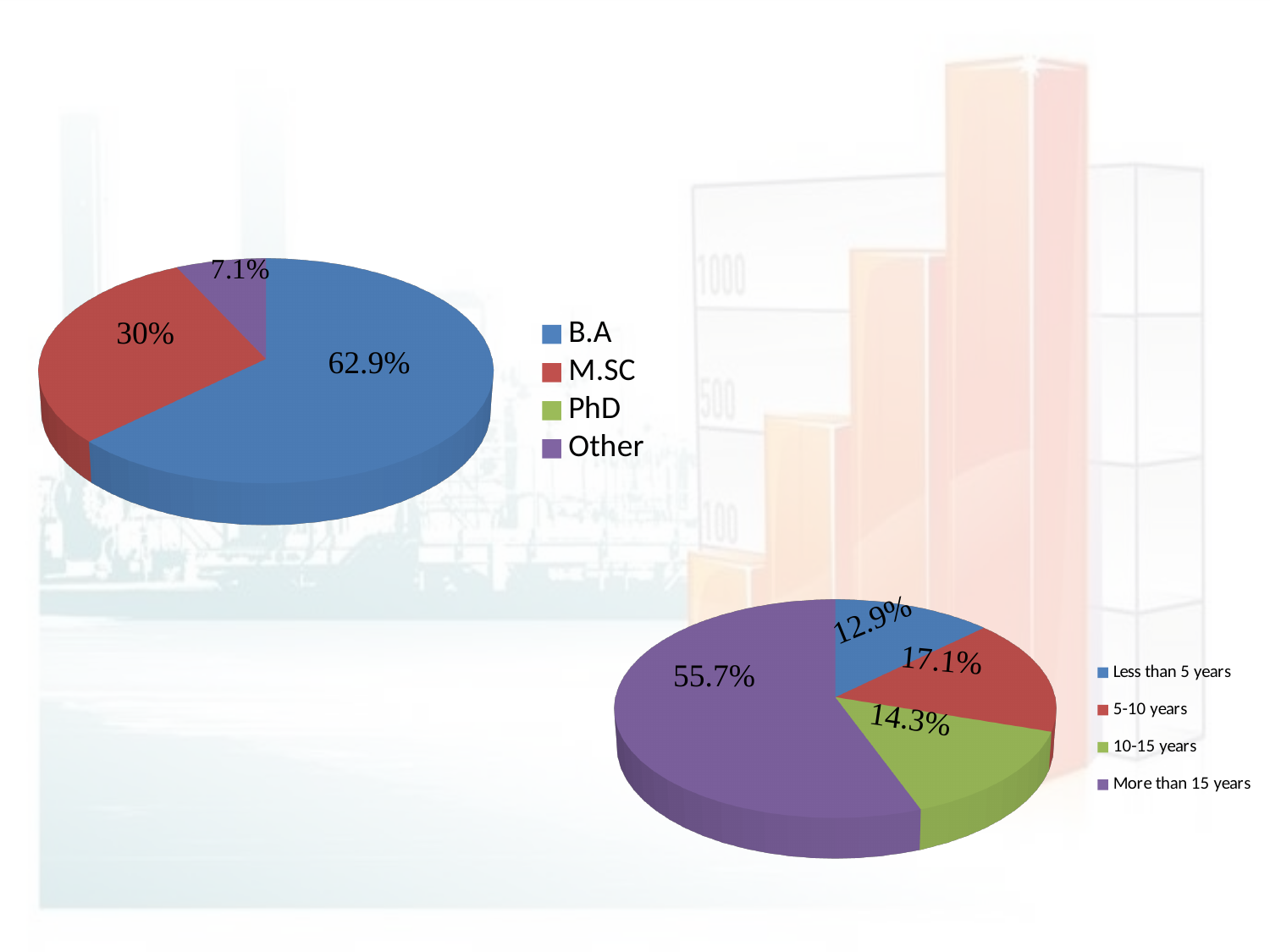
What type of chart is the top-left chart? Pie chart How many categories does the bottom-right pie chart's legend list? 4 In the bottom-right pie chart, which category has the smallest slice? Less than 5 years In the top-left pie chart, what is the difference between the B.A and M.SC percentages? 32.9% In the top-left pie chart, which category has the largest slice? B.A In the top-left pie chart, what percentage is shown for M.SC? 30% In the bottom-right pie chart, which is larger: 5-10 years or 10-15 years? 5-10 years How many entries does the legend of the top-left pie chart list? 4 In the top-left pie chart, what percentage is shown for B.A? 62.9% In the bottom-right pie chart, what percentage is shown for More than 15 years? 55.7% In the bottom-right pie chart, what percentage is shown for 10-15 years? 14.3% In the bottom-right pie chart, what is the difference between the 5-10 years and Less than 5 years percentages? 4.2%